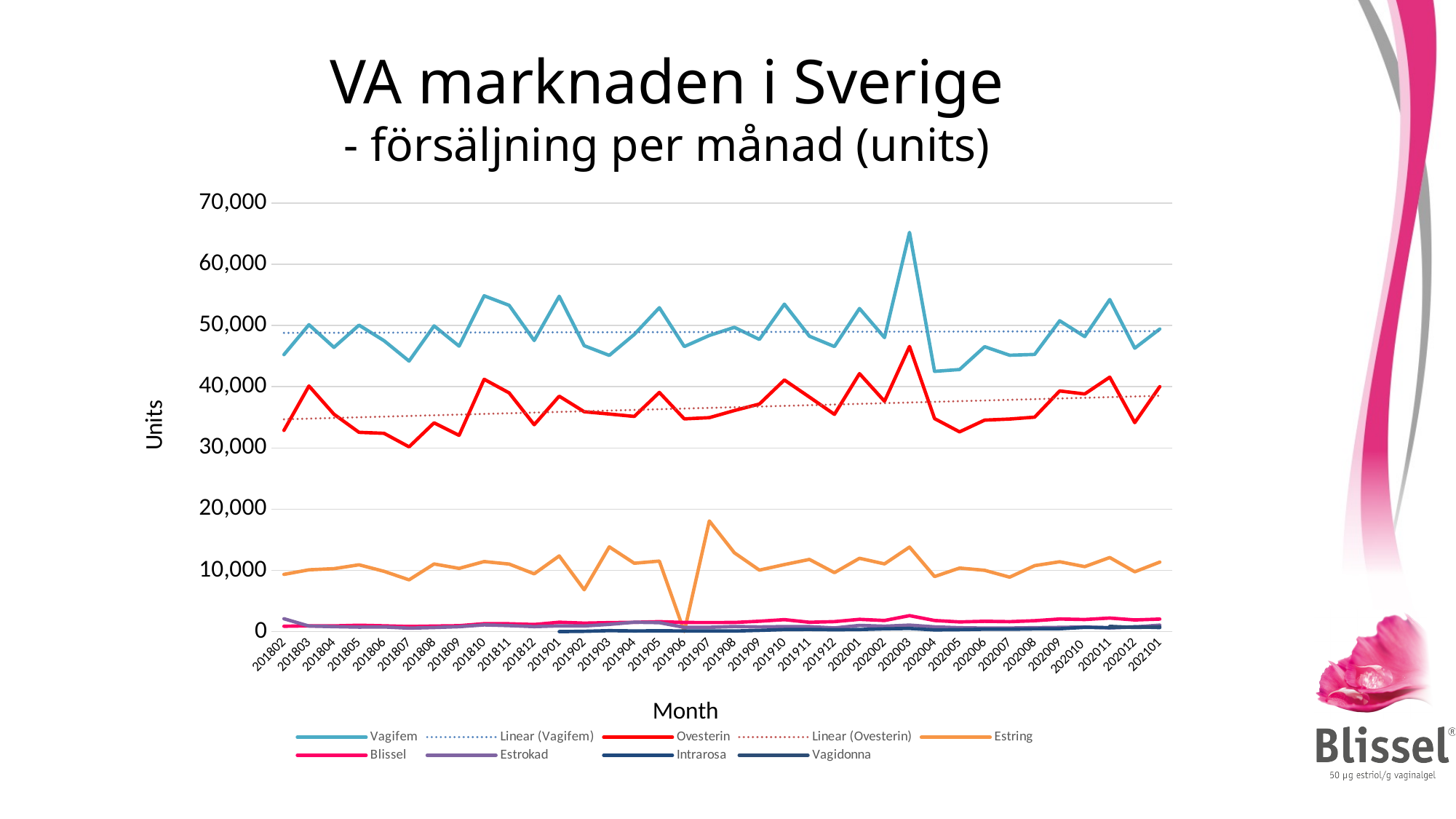
Does the Linear (Ovesterin) trendline rise or fall from left to right? rise What kind of chart is shown on the slide? line chart Which series has the highest values across the whole period? Vagifem What is the title of the vertical axis? Units How many months are plotted along the x axis? 36 How many entries does the chart legend list? 9 Is the value for Vagifem in 202003 greater or less than 60,000? greater Which is larger in 201802, the value for Vagifem or the value for Ovesterin? Vagifem Is the value for Ovesterin in 201807 greater or less than 40,000? less In which month does the Estring line drop to its lowest point? 201906 In which month does the Vagifem line reach its highest point? 202003 Is the value for Estring in 201907 greater or less than 10,000? greater